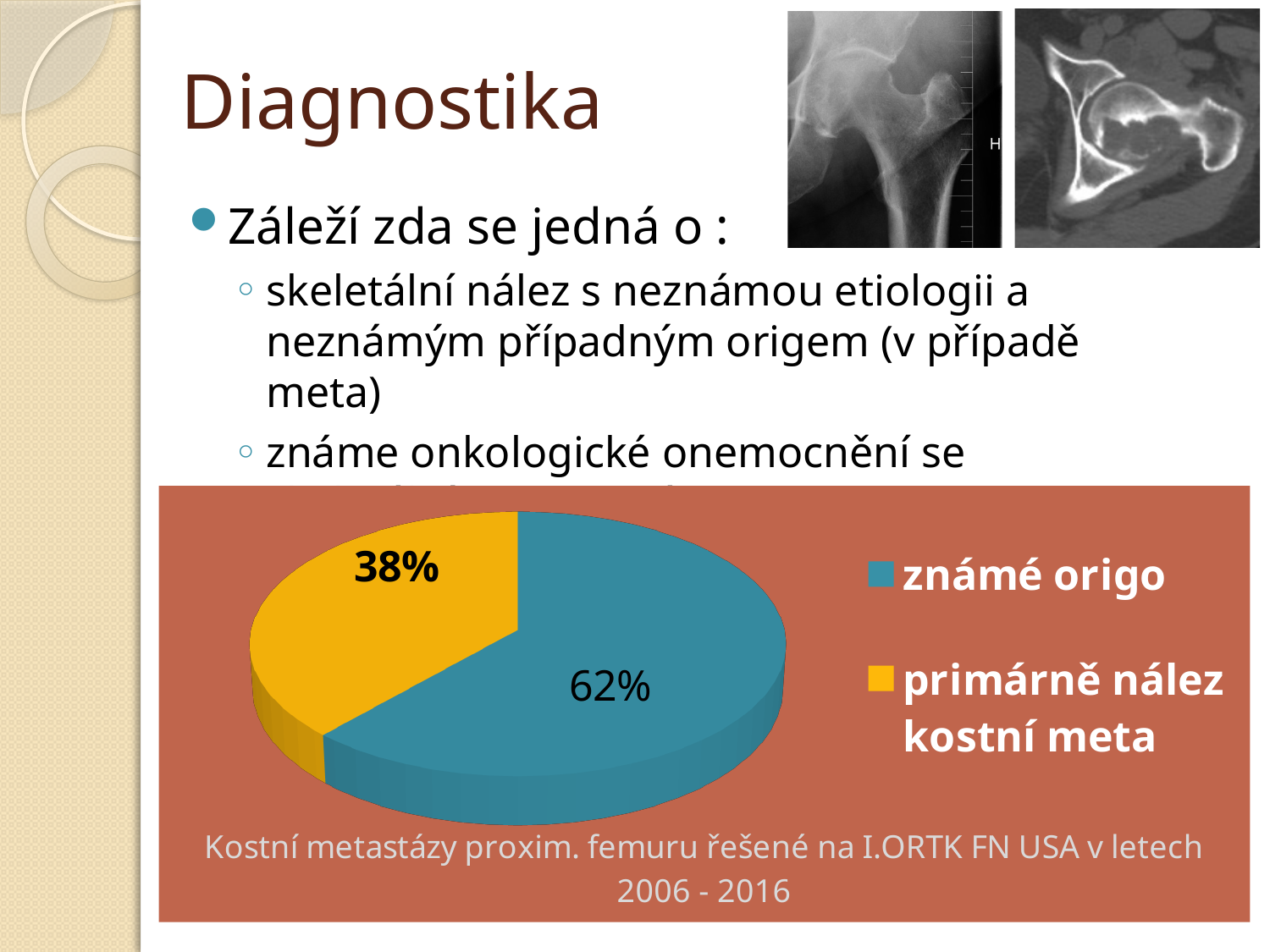
Which slice of the pie is the largest? známé origo What share of the pie does "primárně nález kostní meta" represent? 38% What kind of chart is shown on the slide? pie chart What is the caption text below the pie chart? Kostní metastázy proxim. femuru řešené na I.ORTK FN USA v letech 2006 - 2016 What share of the pie does "známé origo" represent? 62% What is the difference in percentage points between the "známé origo" slice and the "primárně nález kostní meta" slice? 24 What colour is the "známé origo" slice? blue How many slices does the pie chart have? 2 Which slice of the pie is the smallest? primárně nález kostní meta Which is larger: the "známé origo" slice or the "primárně nález kostní meta" slice? známé origo How many entries does the legend list? 2